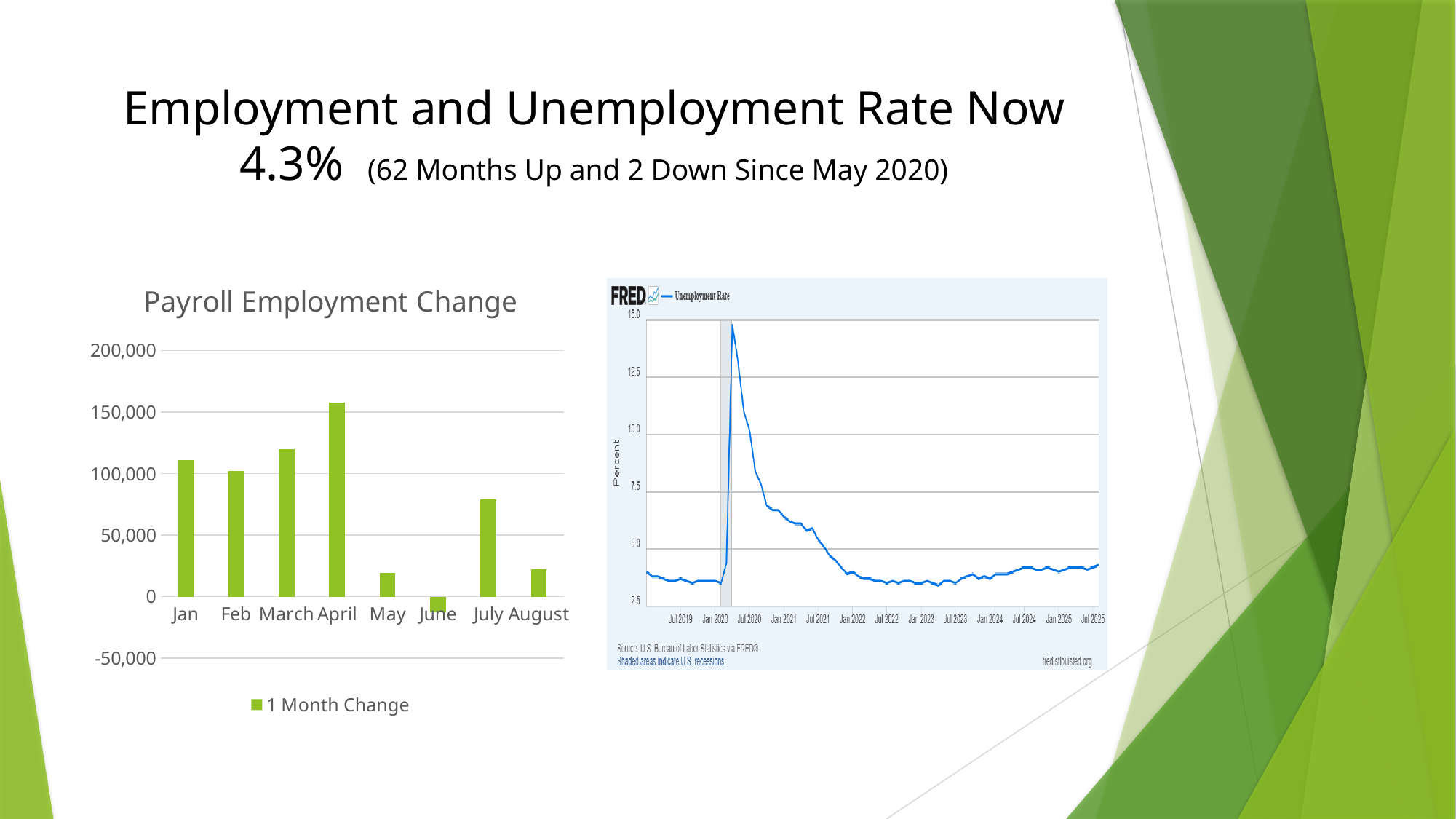
What kind of chart is the Payroll Employment Change chart? bar chart In the Payroll Employment Change chart, which is larger, the value for March or the value for Feb? March What kind of chart is the FRED Unemployment Rate chart? line chart In the Payroll Employment Change chart, which is larger, the value for July or the value for August? July What is the legend entry in the Payroll Employment Change chart? 1 Month Change In the FRED Unemployment Rate chart, is the peak value in 2020 greater or less than 12.5? greater In the Payroll Employment Change chart, is the value for June greater or less than 0? less In the Payroll Employment Change chart, which month has the highest value? April In the Payroll Employment Change chart, which month has the lowest value? June How many months are shown in the Payroll Employment Change chart? 8 In the Payroll Employment Change chart, is the value for May greater or less than 50,000? less